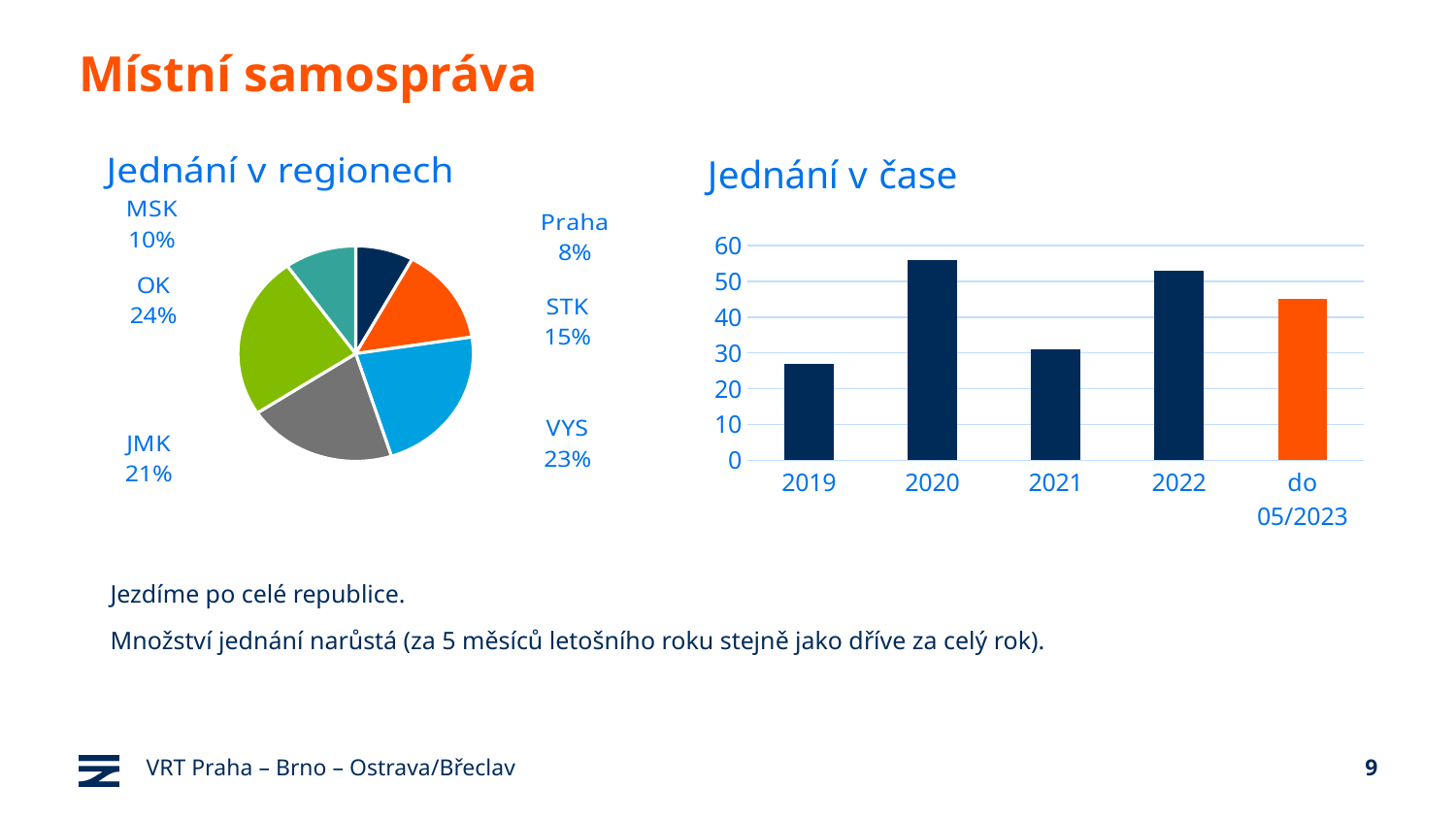
What kind of chart is 'Jednání v čase'? bar chart In the pie chart 'Jednání v regionech', which region has the smallest share? Praha In the bar chart 'Jednání v čase', is the value for 2019 greater or less than 30? less In the pie chart 'Jednání v regionech', which region has the largest share? OK In the pie chart 'Jednání v regionech', what share does Praha have? 8% In the pie chart 'Jednání v regionech', which has the larger share, VYS or JMK? VYS In the pie chart 'Jednání v regionech', how many regions (slices) are shown? 6 In the pie chart 'Jednání v regionech', how many percentage points larger is the share of OK than the share of Praha? 16 In the bar chart 'Jednání v čase', which period has the lowest bar? 2019 In the pie chart 'Jednání v regionech', what share does OK have? 24% In the bar chart 'Jednání v čase', which period has the highest bar? 2020 In the bar chart 'Jednání v čase', is the value for 'do 05/2023' greater or less than 40? greater